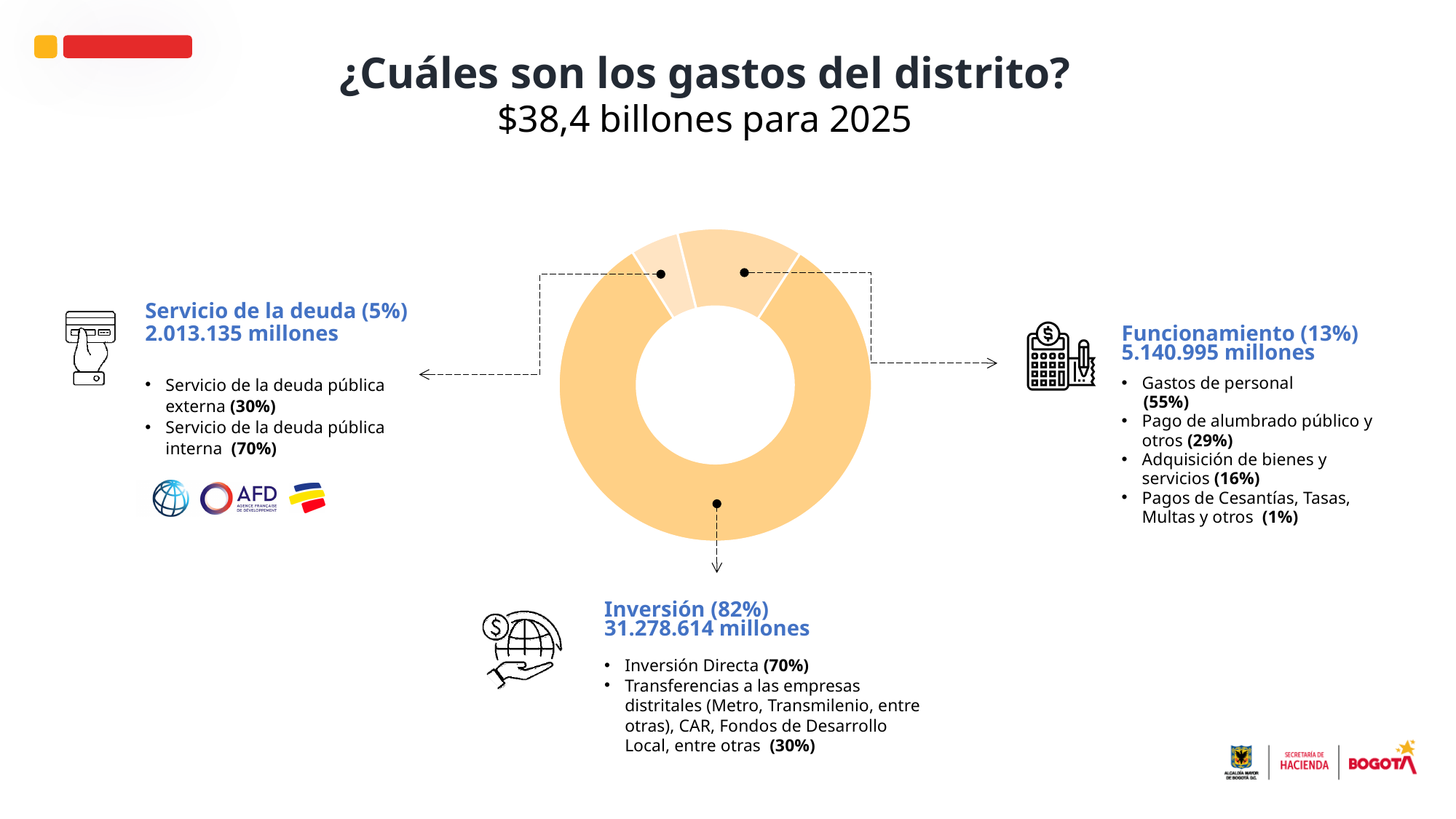
What share of the district's expenses does Inversión represent? 82% What is the amount in millones for Inversión? 31.278.614 millones What kind of chart is shown on the slide? Donut (pie) chart Which is larger, Funcionamiento or Servicio de la deuda? Funcionamiento Which expense category is the largest? Inversión What share of the district's expenses does Funcionamiento represent? 13% What is the difference in percentage points between Funcionamiento and Servicio de la deuda? 8 percentage points What is the amount in millones for Funcionamiento? 5.140.995 millones What share of the district's expenses does Servicio de la deuda represent? 5% What is the amount in millones for Servicio de la deuda? 2.013.135 millones Which expense category is the smallest? Servicio de la deuda How many segments does the donut chart have? 3